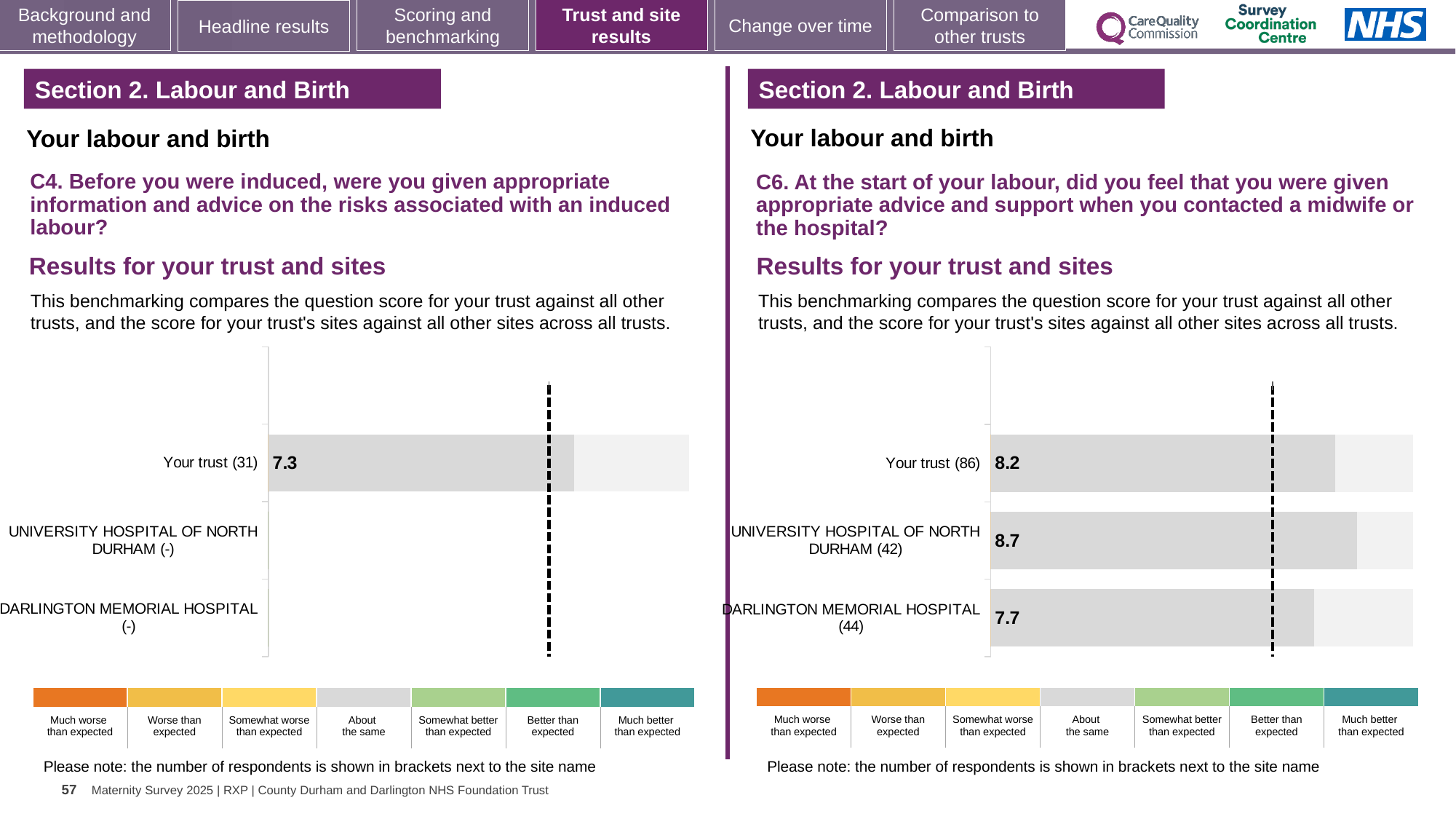
In the right chart (C6), how many respondents are shown in brackets for Your trust? 86 In the right chart (C6), which category has the lowest score? Darlington Memorial Hospital In the left chart (C4), how many categories are listed on the vertical axis? 3 In the left chart (C4), how many respondents are shown in brackets for Your trust? 31 In the right chart (C6), what is the score for Your trust? 8.2 In the right chart (C6), which is larger: the score for Your trust or the score for Darlington Memorial Hospital? Your trust In the right chart (C6), which category has the highest score? University Hospital of North Durham In the left chart (C4), what is the score for Your trust? 7.3 What kind of chart is used in the right chart (C6)? Bar chart In the right chart (C6), what is the difference between the scores for University Hospital of North Durham and Darlington Memorial Hospital? 1.0 In the right chart (C6), what is the score for University Hospital of North Durham? 8.7 In the right chart (C6), what is the score for Darlington Memorial Hospital? 7.7